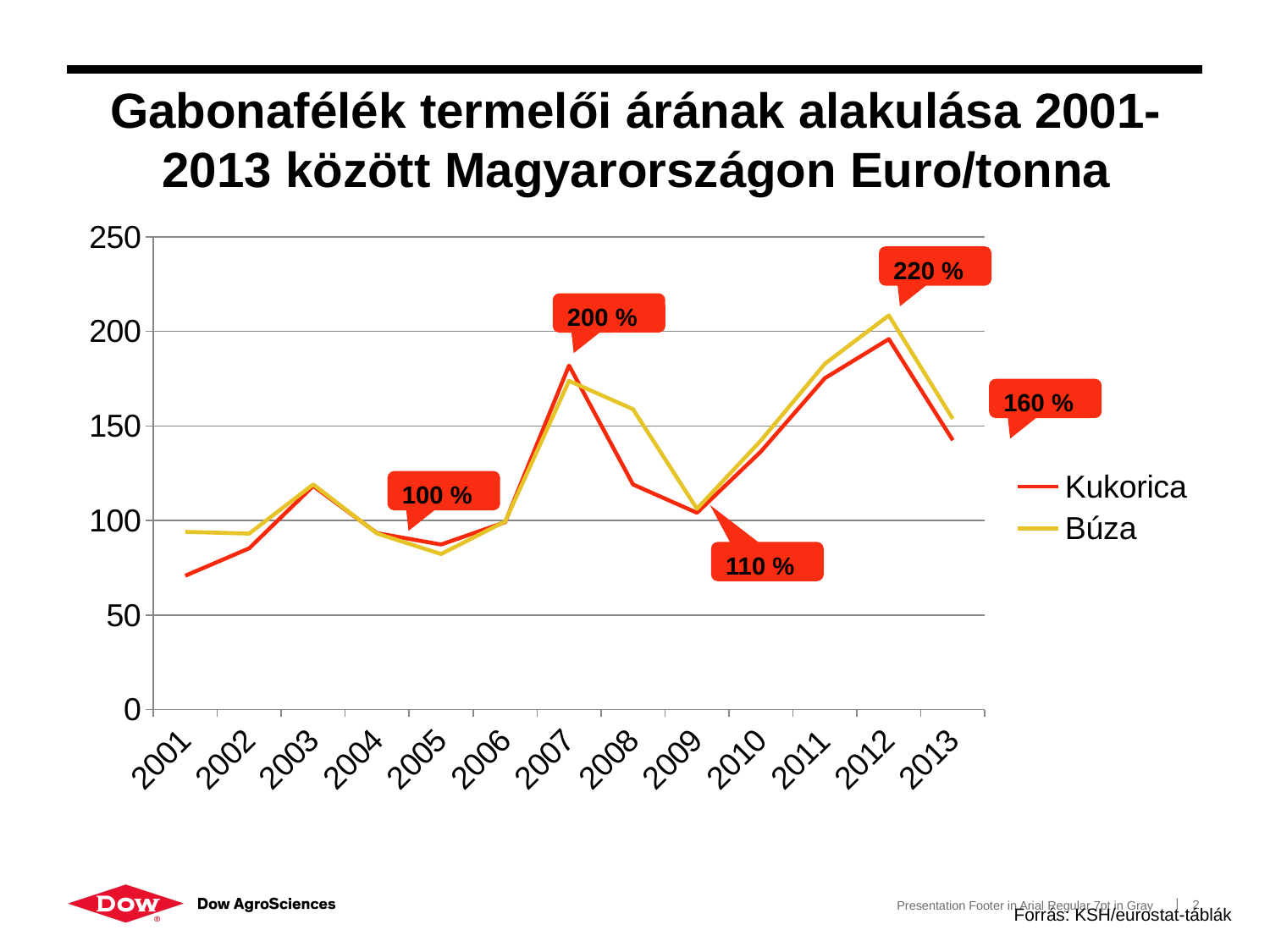
Is the value for Kukorica in 2001 greater or less than 100? less Is the value for Búza in 2008 greater or less than 150? greater What are the two series names listed in the legend? Kukorica and Búza In which year does the Kukorica series have its lowest value? 2001 Does the Kukorica series rise or fall from 2009 to 2012? rise How many years are shown on the x axis? 13 Is the value for Kukorica in 2007 greater or less than 150? greater In 2001, which series has the higher value, Kukorica or Búza? Búza What kind of chart is shown on the slide? line chart How many series does the legend list? 2 In 2008, which series has the higher value, Kukorica or Búza? Búza In which year does the Búza series reach its highest value? 2012